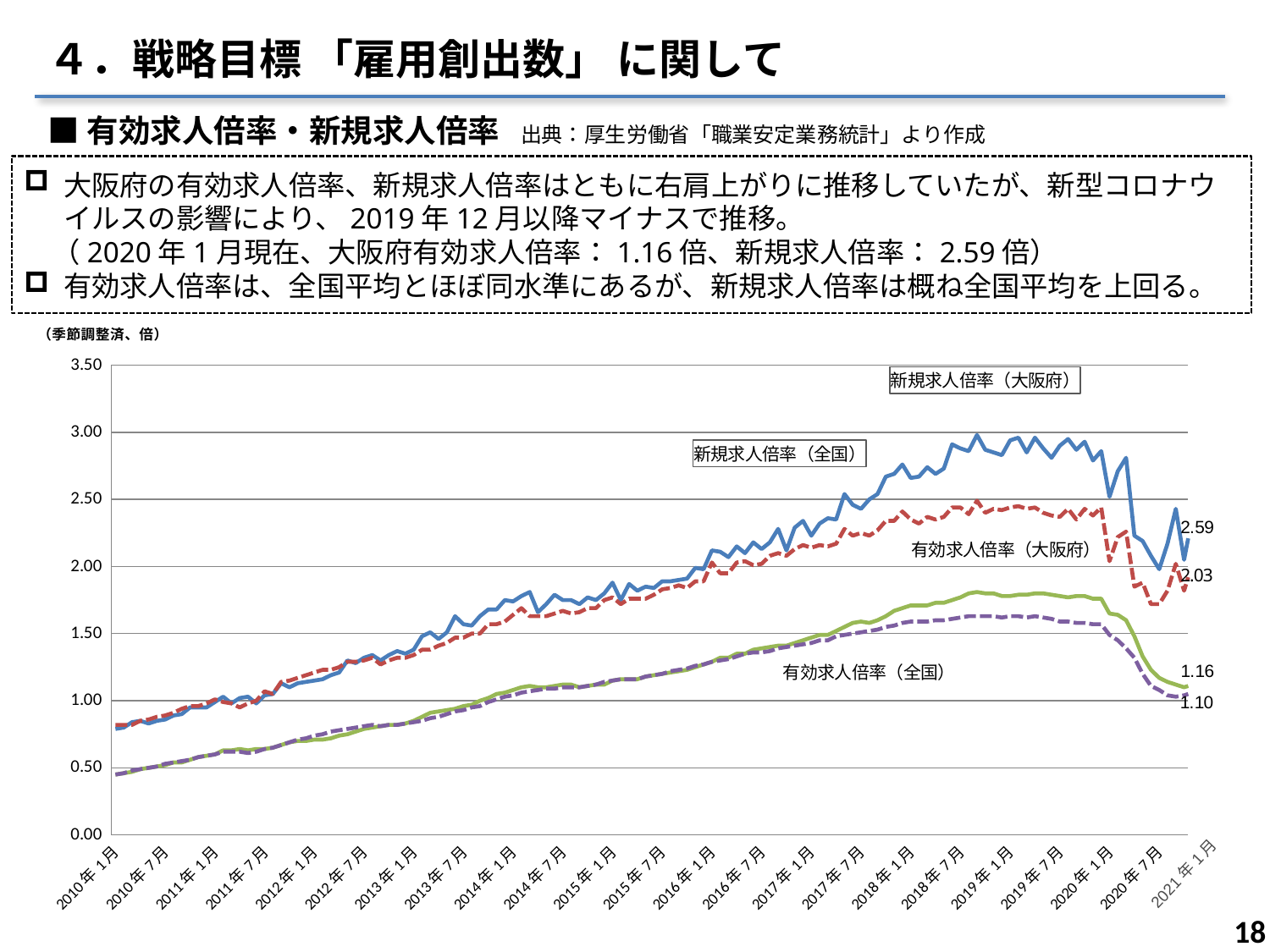
What is the final labelled value for 新規求人倍率（全国）at the right end of the chart? 2.03 How many data series are plotted on the chart? 4 Which series has the lowest final labelled value on the chart? 有効求人倍率（全国） What is the difference between the final labelled values of 新規求人倍率（大阪府）and 新規求人倍率（全国）? 0.56 What is the final labelled value for 有効求人倍率（全国）at the right end of the chart? 1.10 What kind of chart is shown on the slide? line chart What is the final labelled value for 新規求人倍率（大阪府）at the right end of the chart? 2.59 What is the final labelled value for 有効求人倍率（大阪府）at the right end of the chart? 1.16 What is the difference between the final labelled values of 有効求人倍率（大阪府）and 有効求人倍率（全国）? 0.06 Is the value for 新規求人倍率（大阪府）in 2019年1月 greater or less than 2.50? greater Which series has the highest final labelled value on the chart? 新規求人倍率（大阪府） What unit is indicated above the chart's vertical axis? （季節調整済、倍）